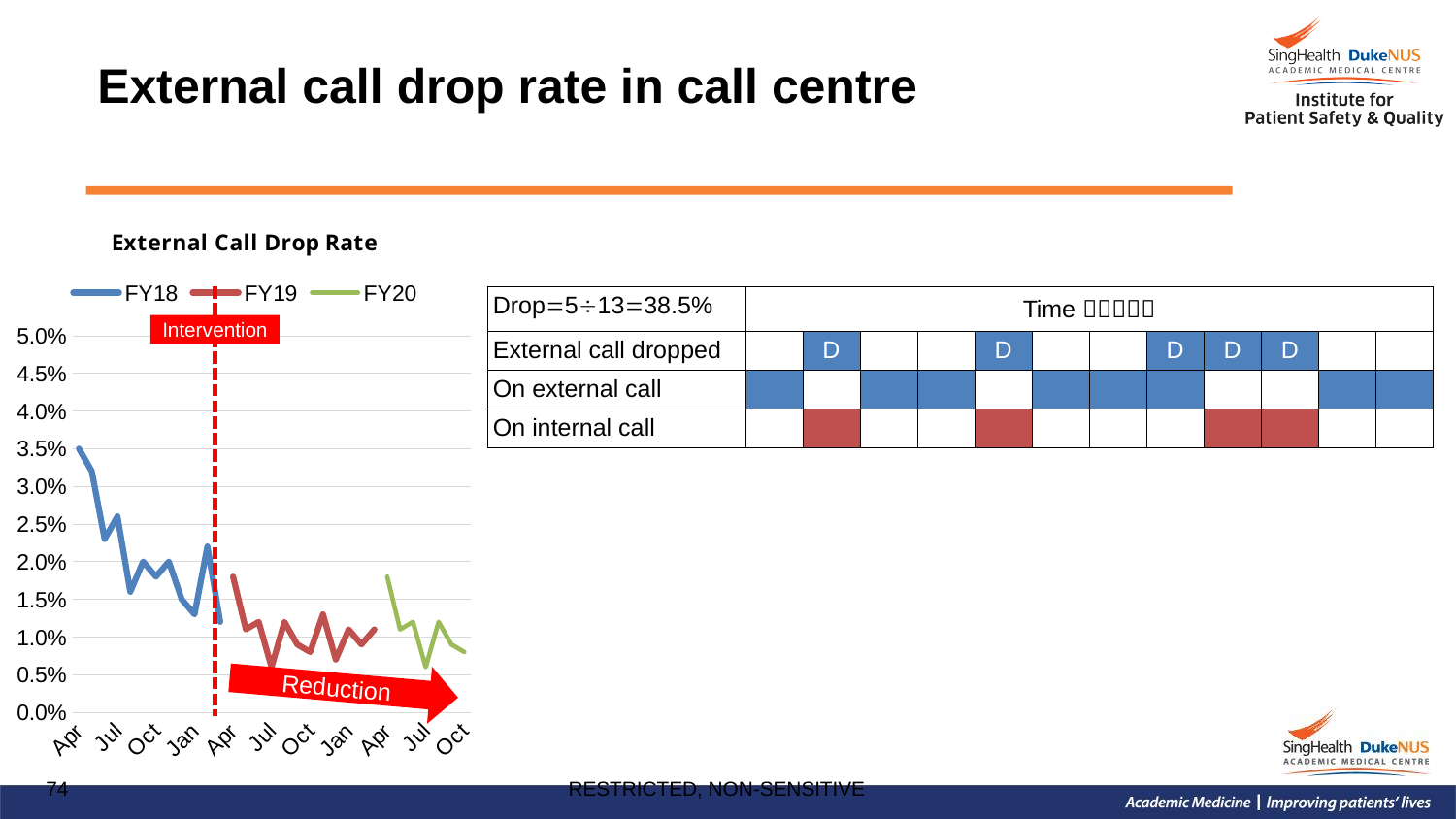
Is the lowest value of the FY18 series greater or less than 1.0%? greater What kind of chart is shown on the slide? line chart Which series in the External Call Drop Rate chart is drawn in blue? FY18 Is the first (Apr) value of the FY18 series greater or less than 3.0%? greater Which series has the higher starting value, FY18 or FY19? FY18 Which series reaches the highest value on the External Call Drop Rate chart? FY18 Is the highest value of the FY19 series greater or less than 2.5%? less What is the highest value shown on the y axis of the External Call Drop Rate chart? 5.0% Does the FY18 series generally rise or fall from Apr to the following Apr? fall How many series does the legend of the External Call Drop Rate chart list? 3 What is the title of the chart on the slide? External Call Drop Rate